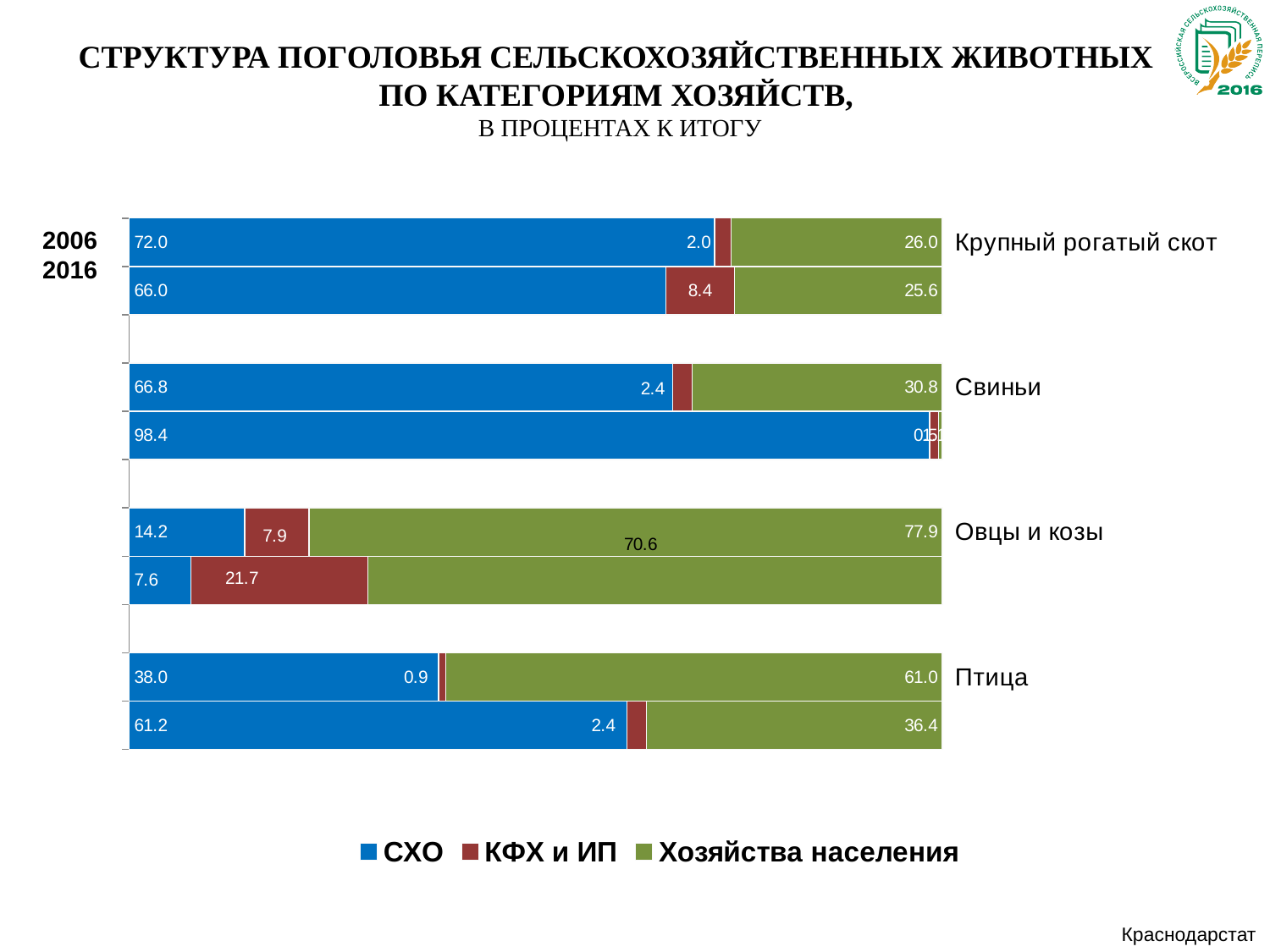
How many series does the legend list? 3 What is the difference between the СХО share for Птица in 2016 and in 2006? 23.2 Which animal category has the lowest share of СХО in 2016? Овцы и козы Which is larger: the КФХ и ИП share for Овцы и козы in 2006 or the КФХ и ИП share for Крупный рогатый скот in 2016? Крупный рогатый скот in 2016 What is the share of КФХ и ИП for Овцы и козы in 2016? 21.7 What is the share of СХО for Свиньи in 2016? 98.4 What is the share of КФХ и ИП for Крупный рогатый скот in 2016? 8.4 What is the share of СХО for Крупный рогатый скот in 2006? 72.0 What is the share of Хозяйства населения for Птица in 2006? 61.0 What kind of chart is shown on the slide? stacked bar chart What is the share of Хозяйства населения for Свиньи in 2006? 30.8 Which animal category has the highest share of Хозяйства населения in 2006? Овцы и козы